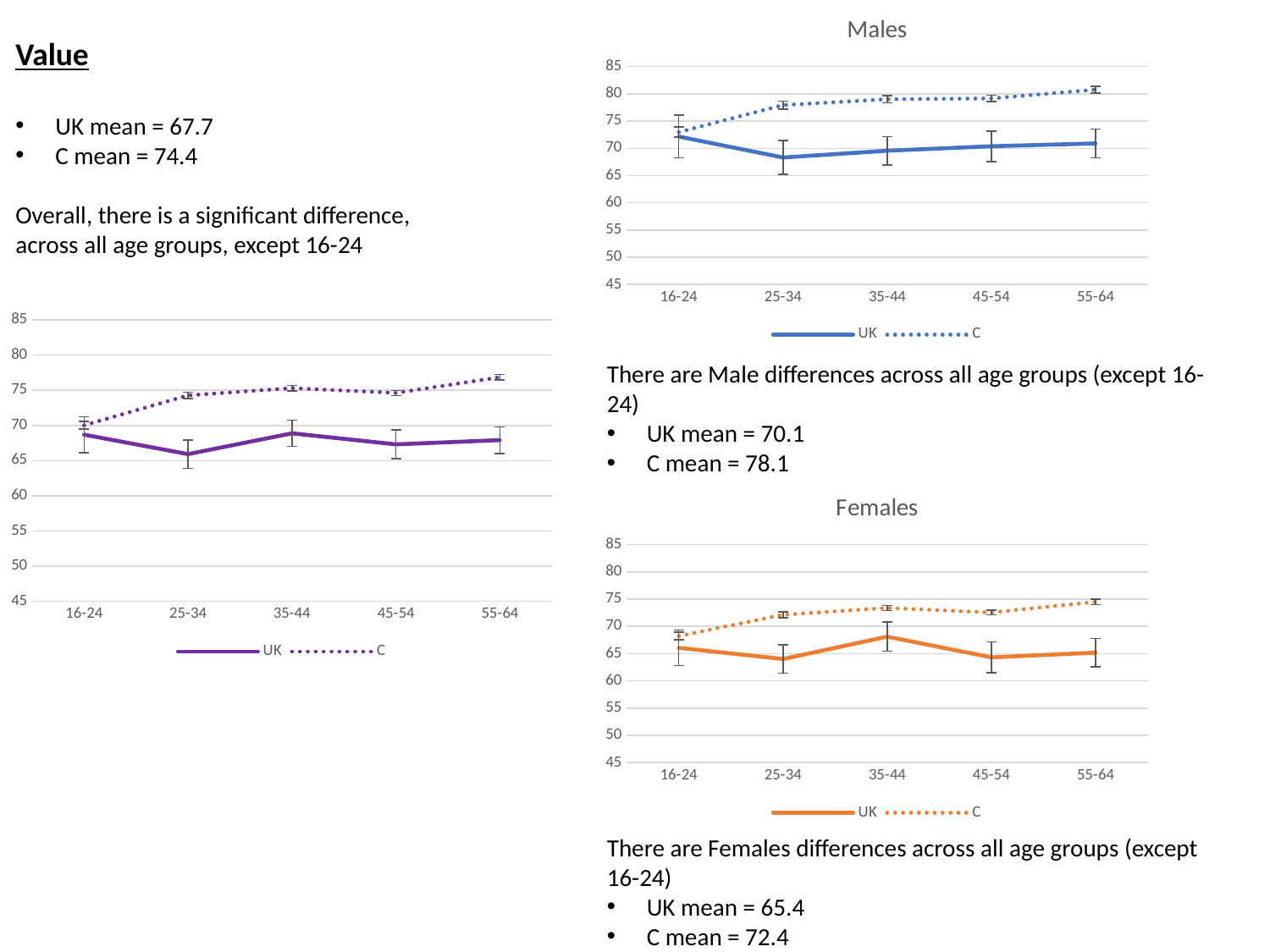
In the 'Males' chart, does the C series rise or fall from 16-24 to 55-64? rise In the 'Males' chart, is the value for C at 55-64 greater or less than 80? greater In the left-hand chart, is the value for C at 55-64 greater or less than 75? greater What kind of chart is the 'Males' chart? line chart In the 'Females' chart, is the value for UK at 25-34 greater or less than 65? less In the left-hand chart, which age group has the highest C value? 55-64 How many age groups are shown on the x axis of the 'Females' chart? 5 In the 'Males' chart, which age group has the lowest UK value? 25-34 In the 'Females' chart, which is larger at 45-54, the UK value or the C value? C In the 'Females' chart, which age group has the highest UK value? 35-44 How many series does the legend of the left-hand chart list? 2